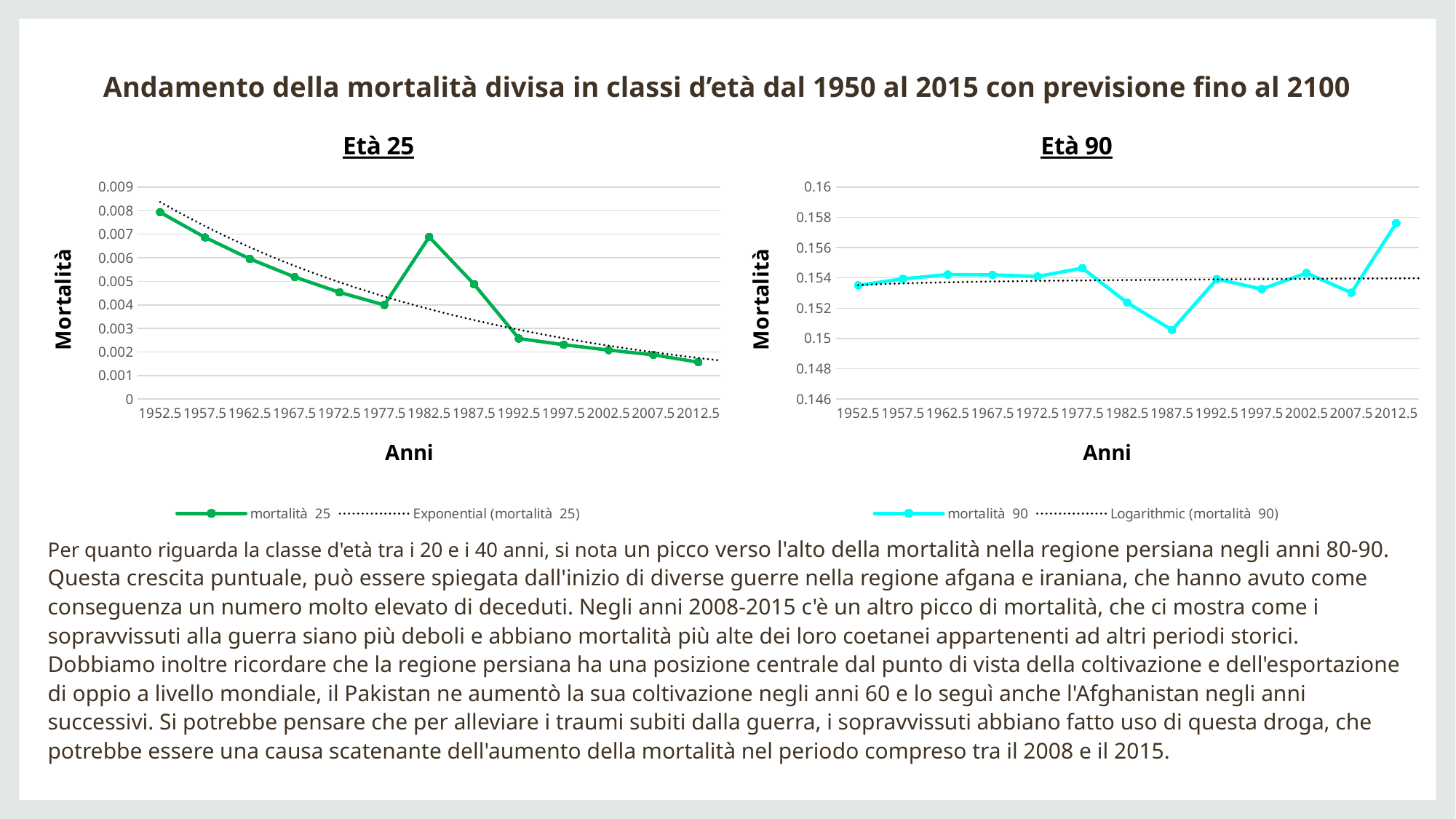
In the 'Età 25' chart, is the mortality value for 1952.5 greater or less than 0.007? greater In the 'Età 25' chart, which year has the larger mortality value, 1977.5 or 1982.5? 1982.5 In the 'Età 25' chart, which year has the lowest mortality value? 2012.5 How many entries does the legend of the 'Età 90' chart list? 2 How many data points are plotted on the 'Età 90' chart? 13 In the 'Età 90' chart, which year has the lowest mortality value? 1987.5 In the 'Età 25' chart, is the mortality value for 2012.5 greater or less than 0.002? less In the 'Età 25' chart, which year has the highest mortality value? 1952.5 In the 'Età 90' chart, is the mortality value for 1987.5 greater or less than 0.152? less What kind of chart is the 'Età 25' chart? line chart In the 'Età 25' chart, do the mortality values overall rise or fall from 1952.5 to 2012.5? fall In the 'Età 90' chart, which year has the highest mortality value? 2012.5